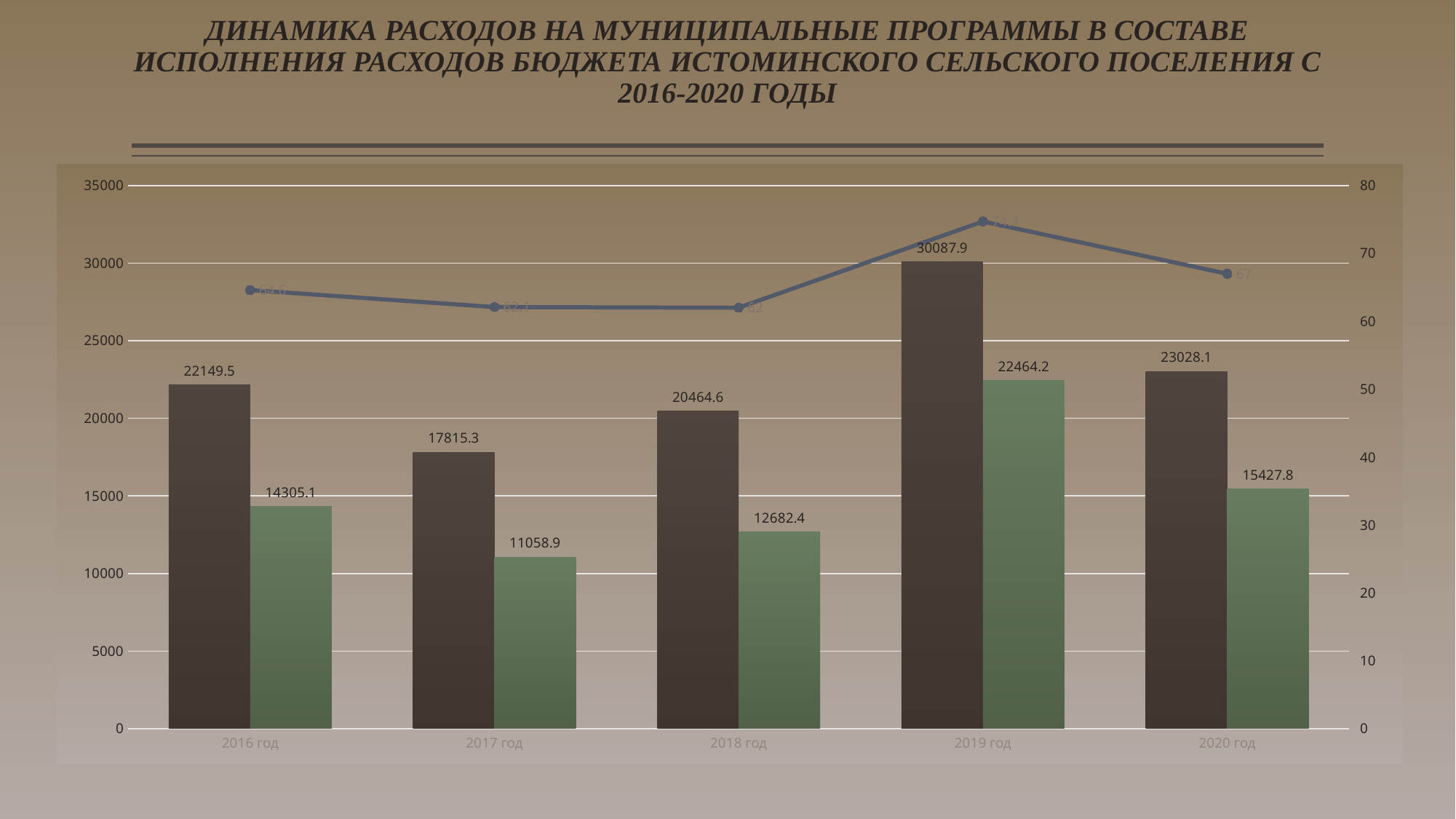
What is the value shown on the green bar for 2017 год? 11058.9 What is the value of the line point for 2020 год on the right axis? 67 How many years are shown on the x axis? 5 What is the value shown on the green bar for 2020 год? 15427.8 Is the green bar for 2019 год greater or less than 20000? greater Do the dark bars rise or fall from 2018 год to 2019 год? rise Which is larger: the dark bar for 2020 год or the dark bar for 2017 год? 2020 год Which year has the lowest green bar? 2017 год Which year has the highest dark bar? 2019 год What is the value shown on the dark bar for 2019 год? 30087.9 What is the value shown on the dark bar for 2016 год? 22149.5 What is the difference between the dark bar and the green bar for 2018 год? 7782.2